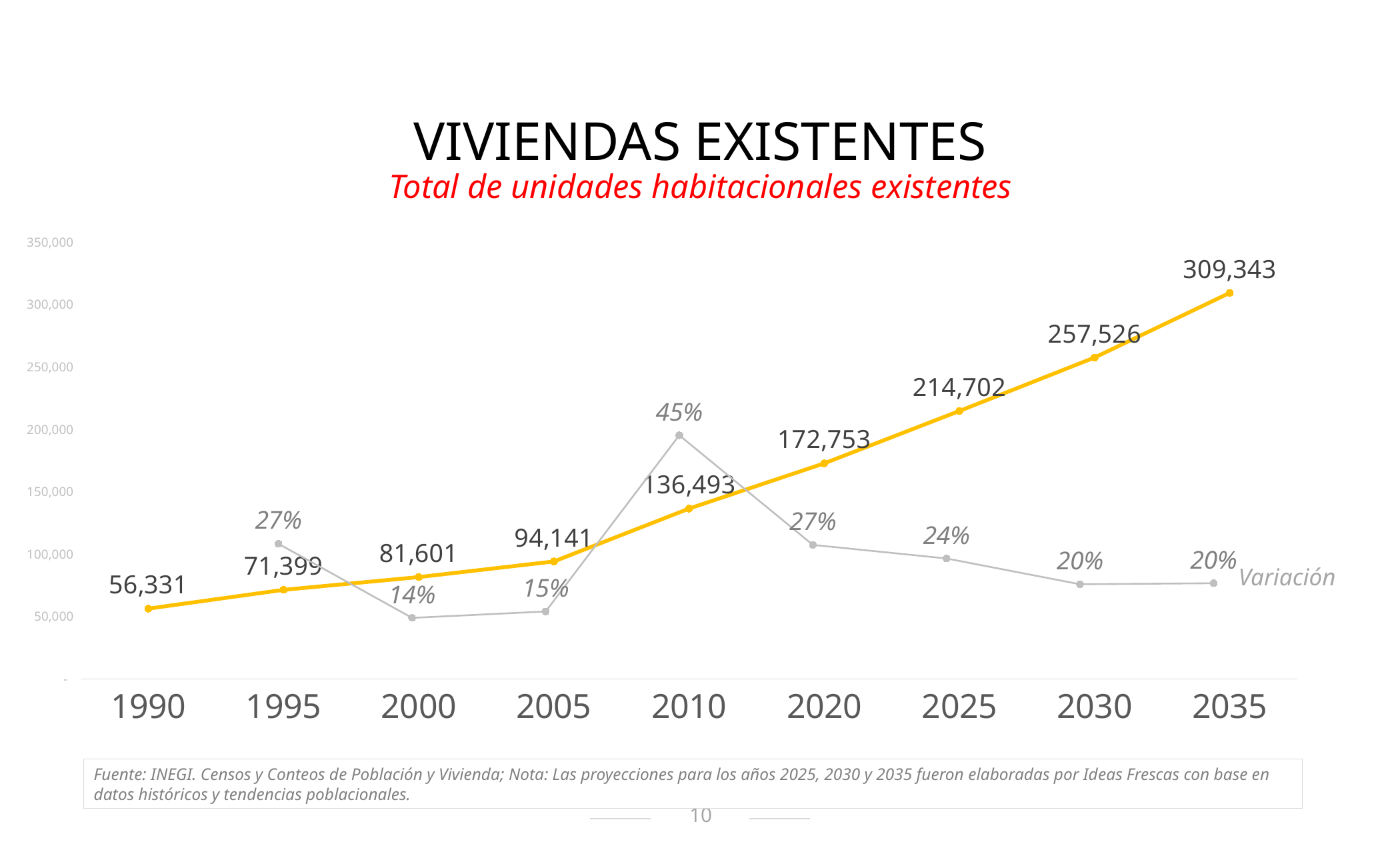
What is the Variación percentage shown for 2010? 45% What value is shown for 2035? 309,343 Which is larger, the housing units value for 2005 or for 2000? 2005 Which year has the lowest number of existing housing units? 1990 What is the difference between the housing units in 2035 and 2030? 51,817 Which year has the highest number of existing housing units? 2035 What kind of chart is shown on the slide? Line chart What is the Variación percentage shown for 2000? 14% What is the total number of existing housing units shown for 2010? 136,493 How many years are plotted on the x axis? 9 Which year shows the highest Variación percentage? 2010 What is the difference between the housing units in 2020 and 2010? 36,260